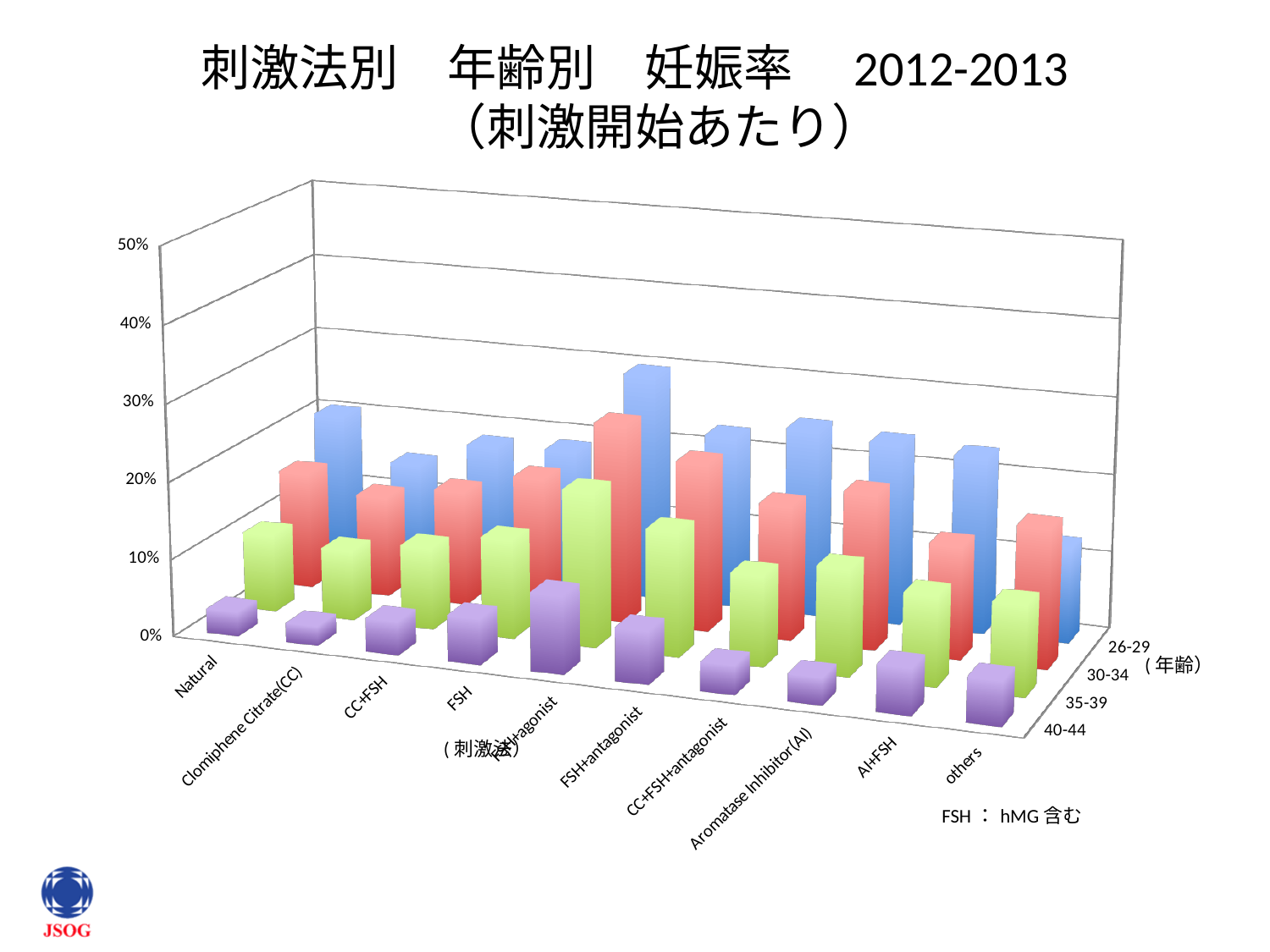
What is the highest value shown on the vertical axis? 50% How many stimulation methods (categories) are shown along the x axis? 10 What note about FSH is printed below the chart? FSH： hMG 含む Within each stimulation method, does the pregnancy rate rise or fall as the age group increases from 26-29 to 40-44? fall For FSH+antagonist, which age group has the higher pregnancy rate, 26-29 or 35-39? 26-29 Which age group has the lowest pregnancy rates across the stimulation methods? 40-44 For Natural, which age group has the higher pregnancy rate, 26-29 or 40-44? 26-29 Among the 26-29 age group, which stimulation method has the highest pregnancy rate? FSH+agonist Is the pregnancy rate for others in the 40-44 age group greater or less than 10%? less How many age groups are plotted in the chart? 4 Is the pregnancy rate for Natural in the 40-44 age group greater or less than 10%? less What kind of chart is shown on the slide? bar chart